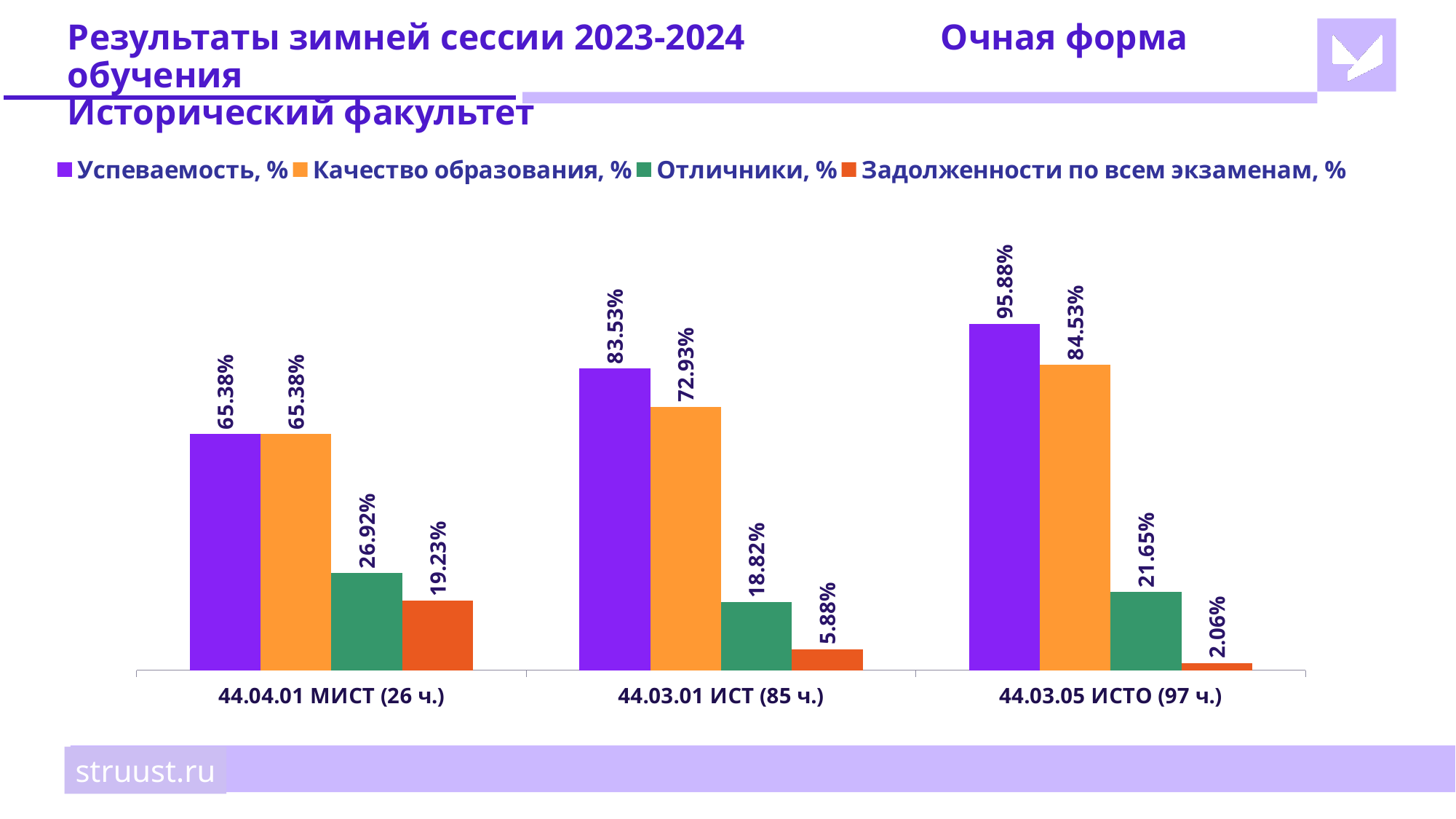
What kind of chart is shown on the slide? Bar chart What is the value of Успеваемость, % for 44.03.01 ИСТ (85 ч.)? 83.53% What is the difference between Успеваемость, % and Качество образования, % for 44.03.01 ИСТ (85 ч.)? 10.60% Which category has the lowest value of Задолженности по всем экзаменам, %? 44.03.05 ИСТО (97 ч.) Which category has the highest value of Успеваемость, %? 44.03.05 ИСТО (97 ч.) How many series does the legend list? 4 Which colour represents Отличники, % in the legend? Green How many categories are shown on the x axis? 3 What is the value of Отличники, % for 44.04.01 МИСТ (26 ч.)? 26.92% What is the value of Качество образования, % for 44.03.05 ИСТО (97 ч.)? 84.53% Which is larger for 44.04.01 МИСТ (26 ч.): Отличники, % or Задолженности по всем экзаменам, %? Отличники, % What is the value of Задолженности по всем экзаменам, % for 44.03.01 ИСТ (85 ч.)? 5.88%